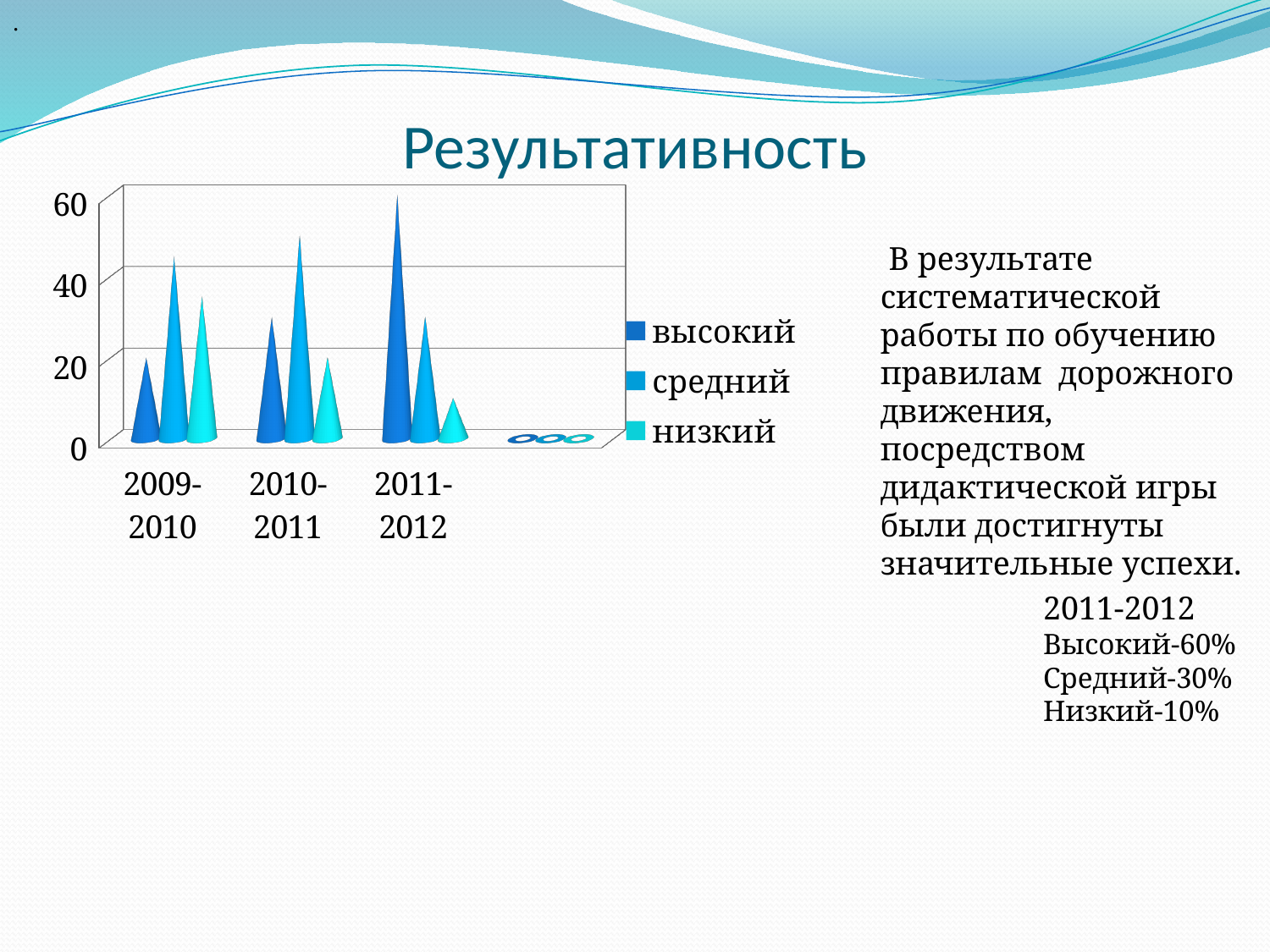
Does the value of the низкий series rise or fall from 2009-2010 to 2011-2012? falls How many series does the chart legend list? 3 Which series has the highest value in the 2009-2010 category? средний Which is larger: the высокий value in 2011-2012 or the средний value in 2011-2012? высокий What kind of chart is shown on the slide? bar chart Which series has the highest value in the 2011-2012 category? высокий Which series does the legend list first? высокий How many categories (school years) are shown on the x axis of the chart? 3 What is the title of the chart on the slide? Результативность Is the value for высокий in 2009-2010 greater or less than 40? less Which series has the lowest value in the 2011-2012 category? низкий Does the value of the высокий series rise or fall from 2009-2010 to 2011-2012? rises